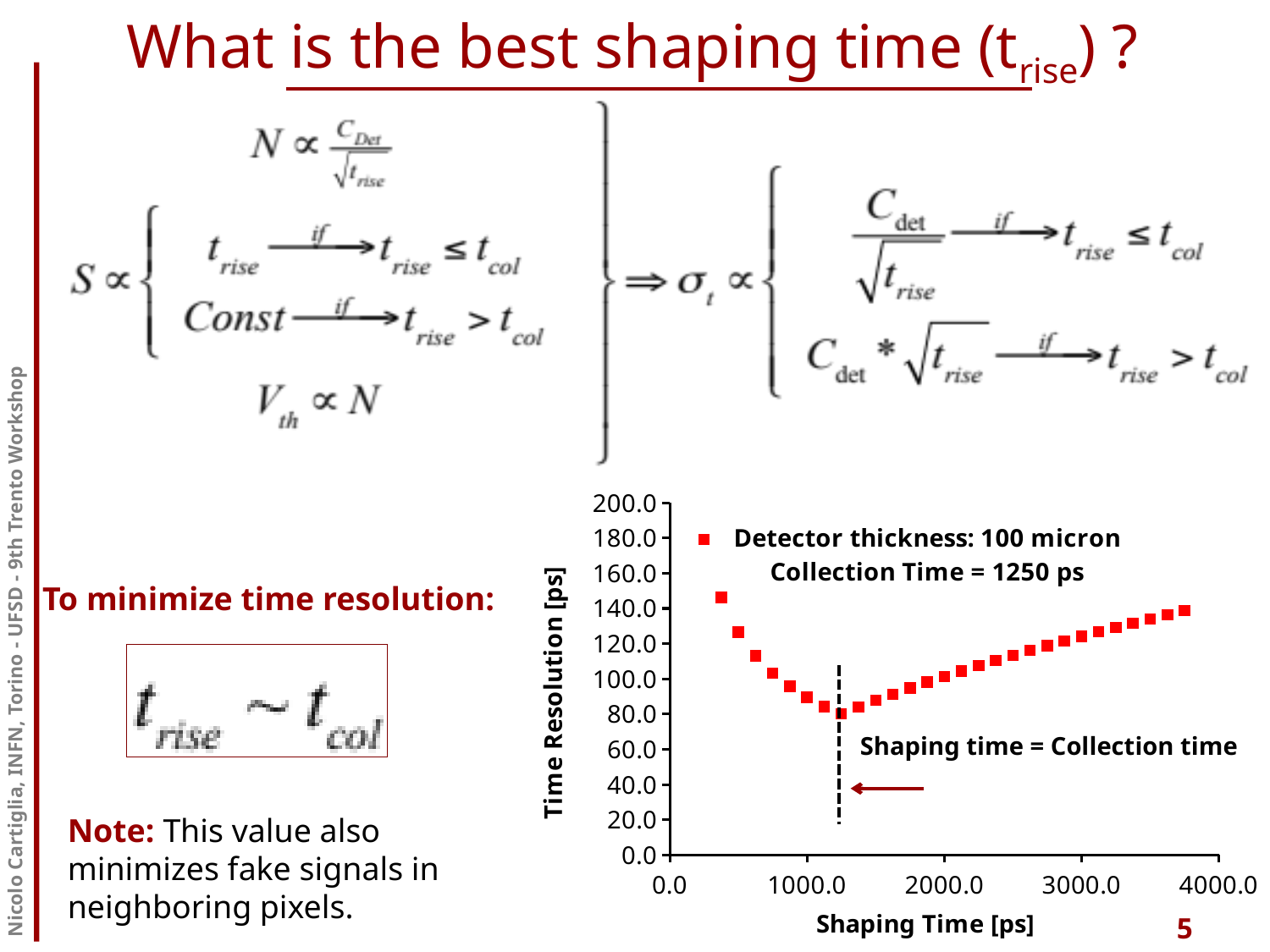
Does the time resolution rise or fall as shaping time increases from about 1250 ps to about 3800 ps? rise What is the maximum value shown on the x axis? 4000.0 What kind of chart is shown on the slide? scatter chart What is the label of the y axis? Time Resolution [ps] Does the time resolution rise or fall as shaping time increases from about 400 ps to about 1250 ps? fall Which is larger: the time resolution at a shaping time of about 400 ps or at about 1250 ps? about 400 ps Is the time resolution at a shaping time of about 1250 ps greater or less than 100? less Is the time resolution at the largest plotted shaping time (about 3800 ps) greater or less than 120? greater Is the time resolution at the smallest plotted shaping time (about 400 ps) greater or less than 120? greater